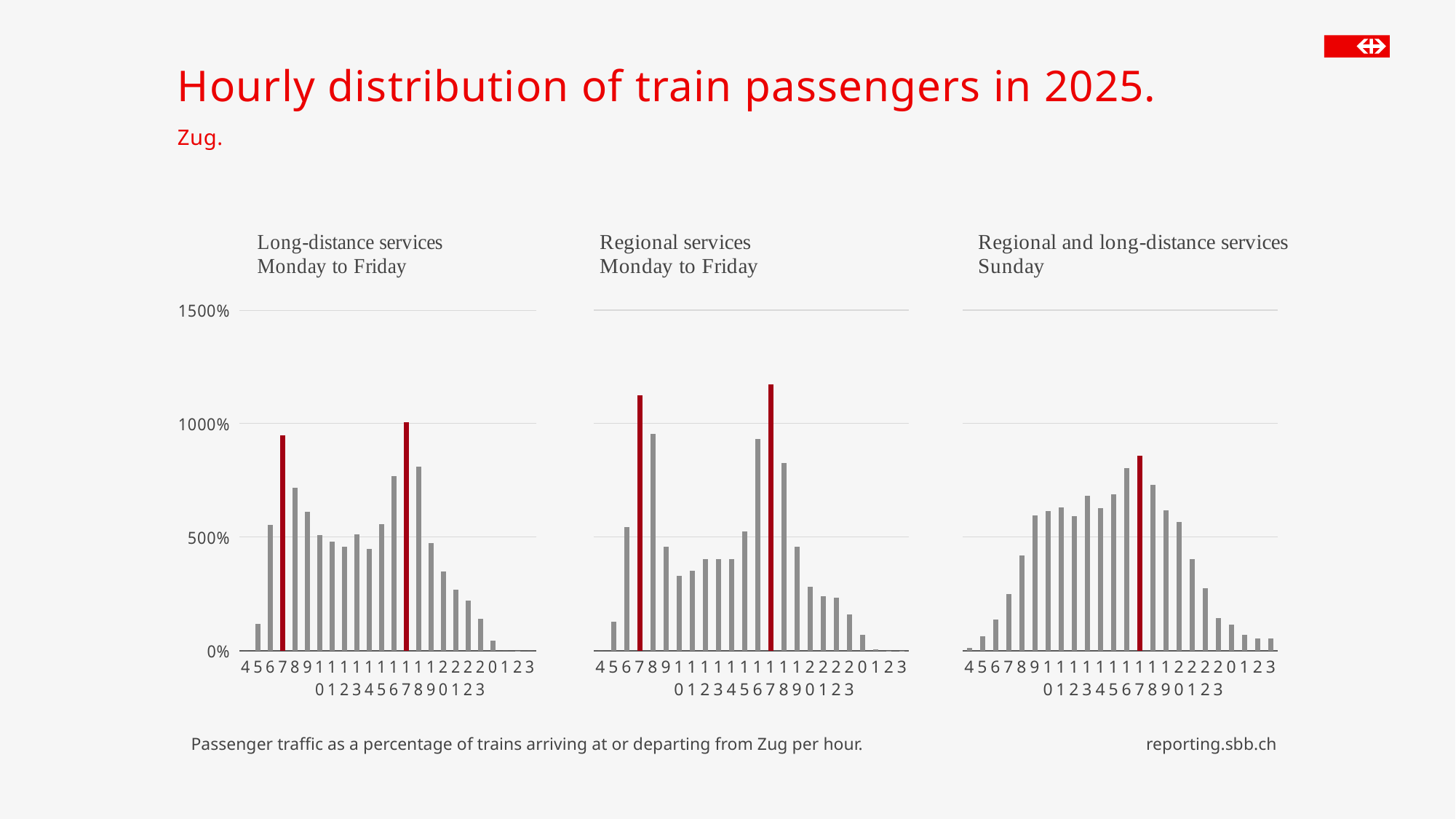
In the 'Regional services Monday to Friday' chart, is the value for hour 17 greater or less than 1000%? greater In the 'Long-distance services Monday to Friday' chart, which is larger, the value for hour 8 or hour 9? hour 8 What is the title of the slide? Hourly distribution of train passengers in 2025. In the 'Regional services Monday to Friday' chart, which is larger, the value for hour 8 or hour 9? hour 8 In the 'Long-distance services Monday to Friday' chart, is the value for hour 23 greater or less than 500%? less In the 'Regional and long-distance services Sunday' chart, is the value for hour 17 greater or less than 1000%? less In the 'Regional and long-distance services Sunday' chart, which hour has the highest value? 17 In the 'Long-distance services Monday to Friday' chart, which hours are highlighted with red bars? 7 and 17 What kind of chart is the 'Long-distance services Monday to Friday' chart? bar chart How many hourly categories are shown on the x axis of the 'Regional services Monday to Friday' chart? 24 In the 'Regional and long-distance services Sunday' chart, do the values rise or fall from hour 17 to hour 23? fall